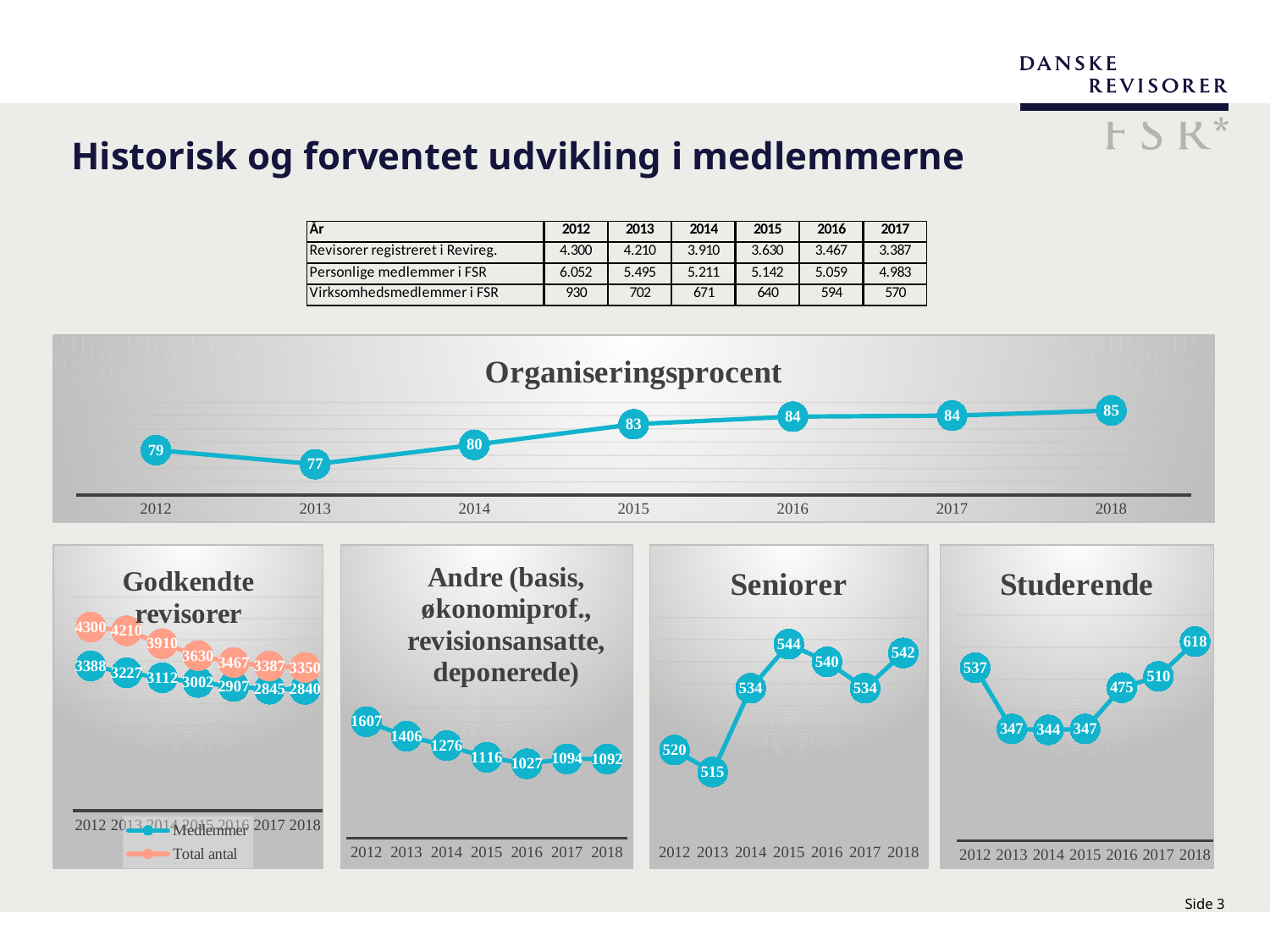
In the 'Andre (basis, økonomiprof., revisionsansatte, deponerede)' chart, what is the difference between the 2012 value and the 2013 value? 201 In the 'Organiseringsprocent' chart, what is the value for 2015? 83 In the 'Studerende' chart, is the value for 2018 larger than the value for 2012? Yes How many data points are plotted in the 'Studerende' chart? 7 In the 'Godkendte revisorer' chart, what is the 'Medlemmer' value for 2018? 2840 What kind of chart is the 'Organiseringsprocent' chart? Line chart In the 'Seniorer' chart, which year has the highest value? 2015 In the 'Godkendte revisorer' chart, what is the 'Total antal' value for 2014? 3910 In the 'Andre (basis, økonomiprof., revisionsansatte, deponerede)' chart, which year has the highest value? 2012 In the 'Organiseringsprocent' chart, what is the difference between the 2018 value and the 2012 value? 6 In the 'Organiseringsprocent' chart, which year has the lowest value? 2013 How many series does the legend of the 'Godkendte revisorer' chart list? 2